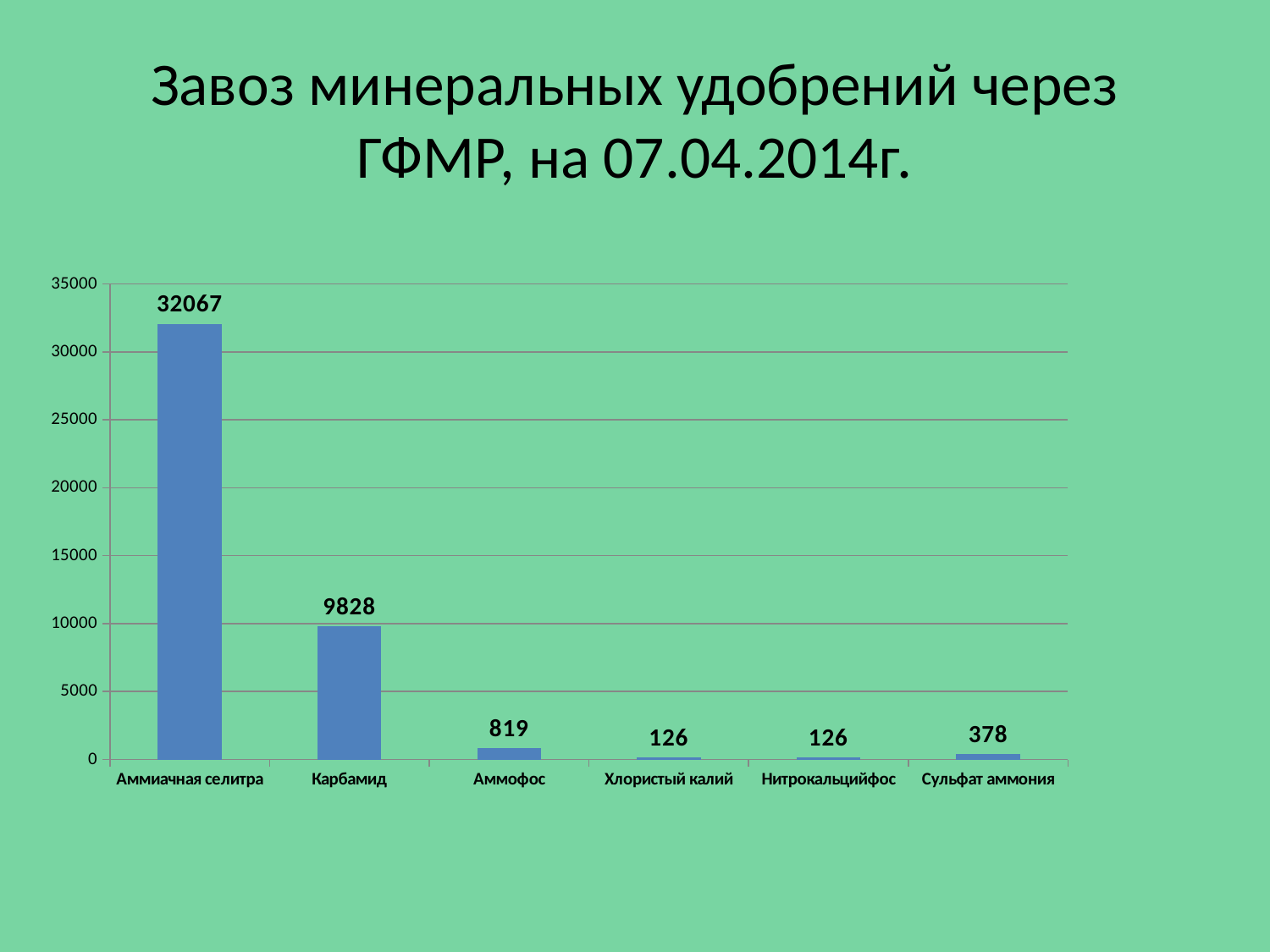
What is the value for Сульфат аммония? 378 Which is larger, the value for Карбамид or the value for Аммофос? Карбамид What is the value for Карбамид? 9828 What is the difference between the values for Аммиачная селитра and Карбамид? 22239 Is the value for Карбамид greater or less than 10000? less What is the title of the slide? Завоз минеральных удобрений через ГФМР, на 07.04.2014г. What is the difference between the values for Аммофос and Сульфат аммония? 441 What is the value for Аммофос? 819 What kind of chart is shown on the slide? bar chart Which category has the highest value? Аммиачная селитра What is the value for Аммиачная селитра? 32067 How many categories are shown on the x axis? 6